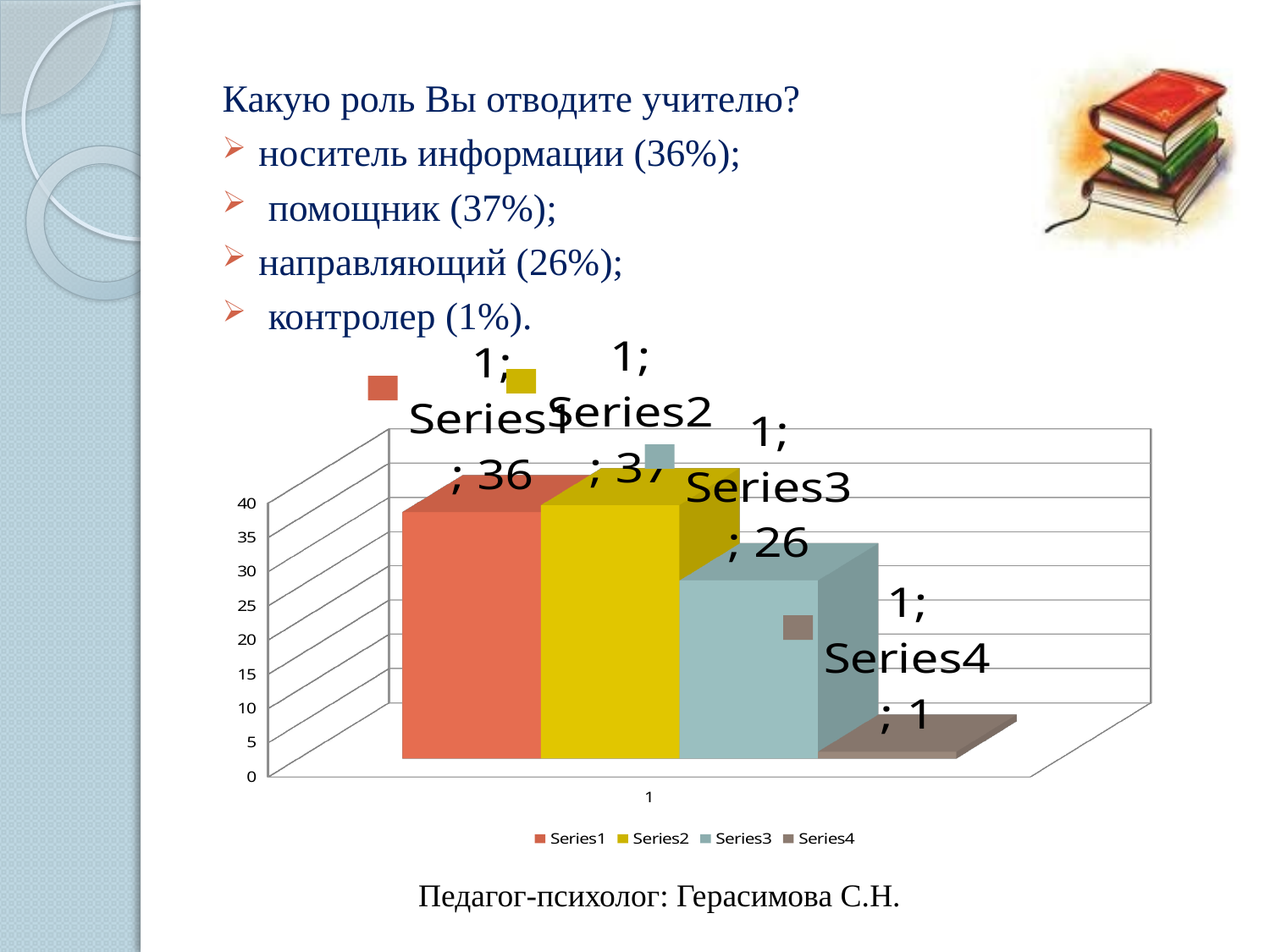
What is the difference between the values of Series3 and Series4? 25 Is the value for Series1 greater or less than 30? greater Which is larger, the value for Series3 or the value for Series4? Series3 What is the value shown for Series3 in the chart? 26 What is the difference between the values of Series1 and Series3? 10 What is the value shown for Series1 in the chart? 36 Is the value for Series4 greater or less than 5? less What is the value shown for Series4 in the chart? 1 What kind of chart is shown on the slide? bar chart Which series has the lowest value in the chart? Series4 Which is larger, the value for Series1 or the value for Series3? Series1 How many series does the legend list? 4